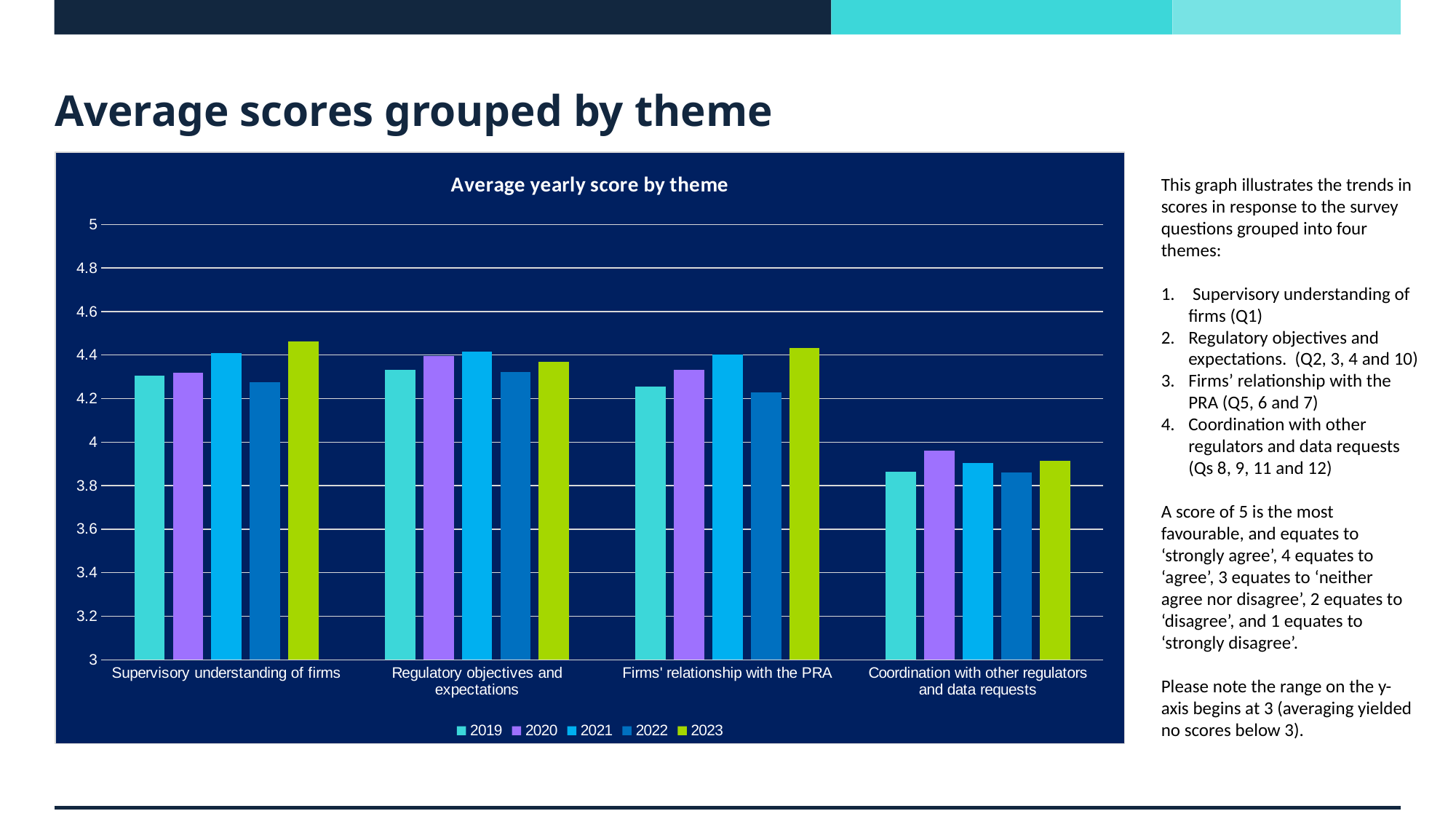
For Regulatory objectives and expectations, which is larger: the 2020 value or the 2022 value? 2020 What kind of chart is shown on the slide? bar chart Is the 2023 value for Supervisory understanding of firms greater or less than 4.4? greater How many theme categories are shown on the x axis? 4 Is the 2019 value for Coordination with other regulators and data requests greater or less than 4? less How many series does the legend list? 5 Is the 2022 value for Firms' relationship with the PRA greater or less than 4.2? greater What is the title of the chart? Average yearly score by theme Which year has the highest score for Supervisory understanding of firms? 2023 Which theme has the lowest scores across all years? Coordination with other regulators and data requests Which year has the highest score for Coordination with other regulators and data requests? 2020